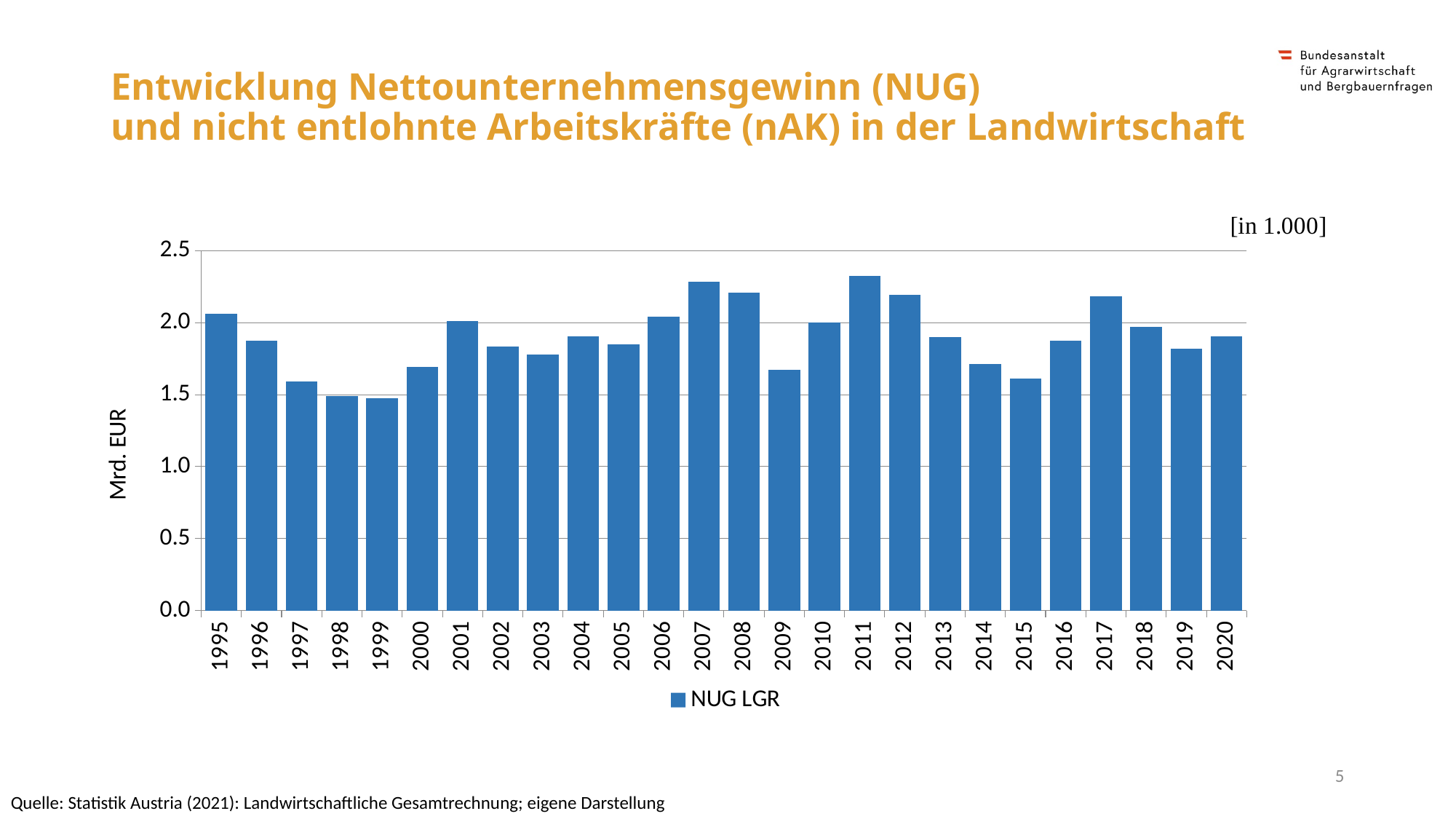
Do the NUG LGR values rise or fall from 1995 to 1999? fall Which year has the highest NUG LGR value in the chart? 2011 What is the label on the y axis of the chart? Mrd. EUR Is the NUG LGR value for 2015 greater or less than 2.0? less Is the NUG LGR value for 2009 greater or less than 2.0? less Is the NUG LGR value for 2014 greater or less than 1.5? greater How many years are shown on the x axis of the chart? 26 Which year has the larger NUG LGR value, 2007 or 2009? 2007 What kind of chart is shown on the slide? bar chart How many series does the chart's legend list? 1 Which year has the larger NUG LGR value, 1996 or 1997? 1996